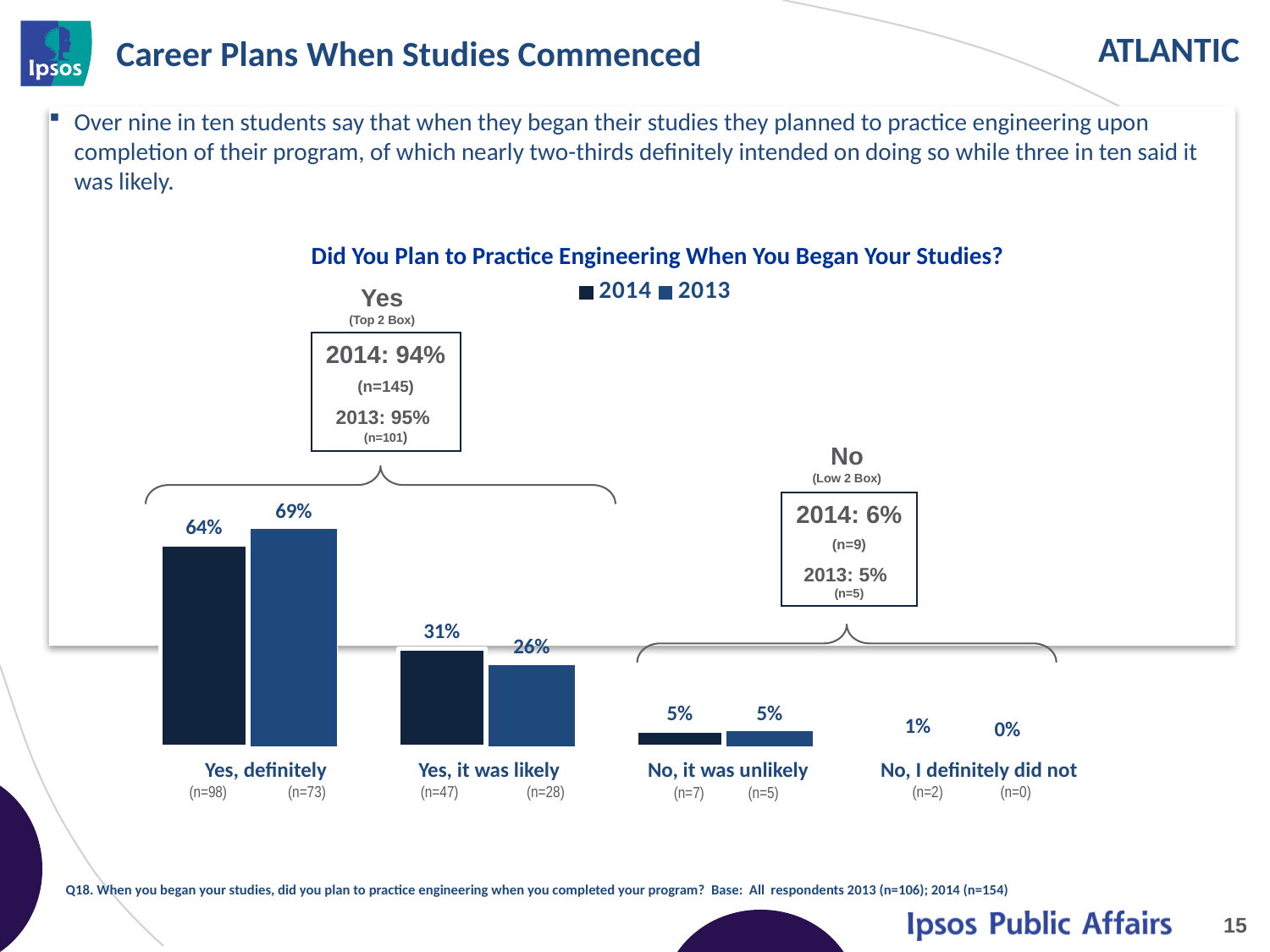
For "Yes, it was likely", which year has the larger value, 2014 or 2013? 2014 Which response category has the highest value for 2013? Yes, definitely What is the 2014 value for "No, I definitely did not"? 1% What is the title of the chart? Did You Plan to Practice Engineering When You Began Your Studies? How many series does the legend list? 2 How many response categories are shown on the x axis? 4 Do the 2014 values rise or fall moving from left to right across the categories? Fall What kind of chart is shown on the slide? Bar chart What percentage of 2014 respondents said "Yes, definitely"? 64% What percentage of 2013 respondents said "Yes, it was likely"? 26% Which response category has the lowest value for 2014? No, I definitely did not What is the difference between the 2013 and 2014 values for "Yes, definitely"? 5%